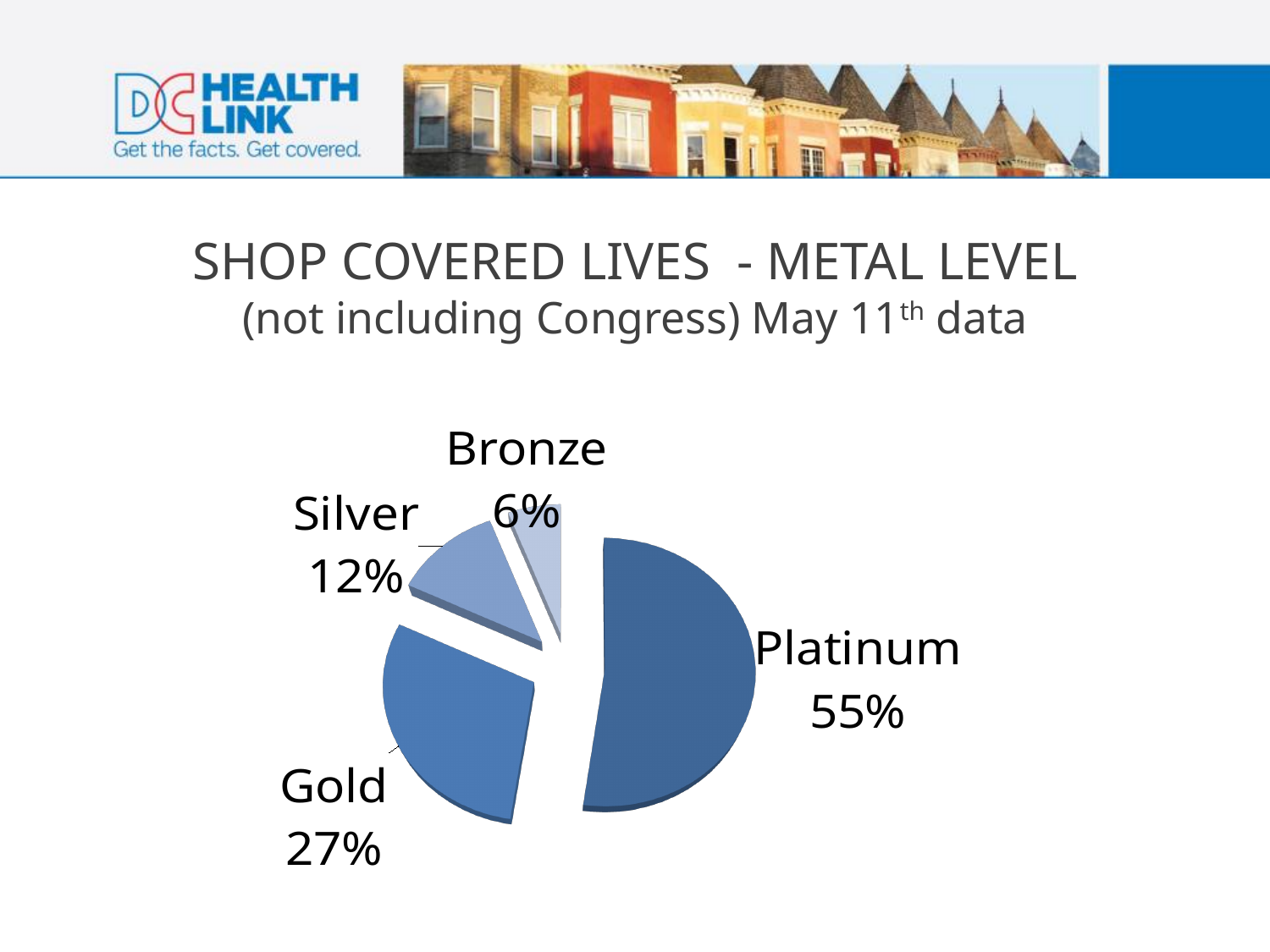
Which has a larger share, Gold or Silver? Gold How many percentage points larger is the Platinum share than the Gold share? 28 What percentage of the pie is Silver? 12% What percentage of the pie is Bronze? 6% Which metal level has the smallest share of SHOP covered lives? Bronze What is the title of the chart on the slide? SHOP COVERED LIVES - METAL LEVEL (not including Congress) May 11th data How many percentage points larger is the Silver share than the Bronze share? 6 What percentage of the pie is Gold? 27% What kind of chart is shown on the slide? Pie chart What share of SHOP covered lives is at the Platinum metal level? 55% Which metal level has the largest share of SHOP covered lives? Platinum How many metal levels are shown in the pie chart? 4